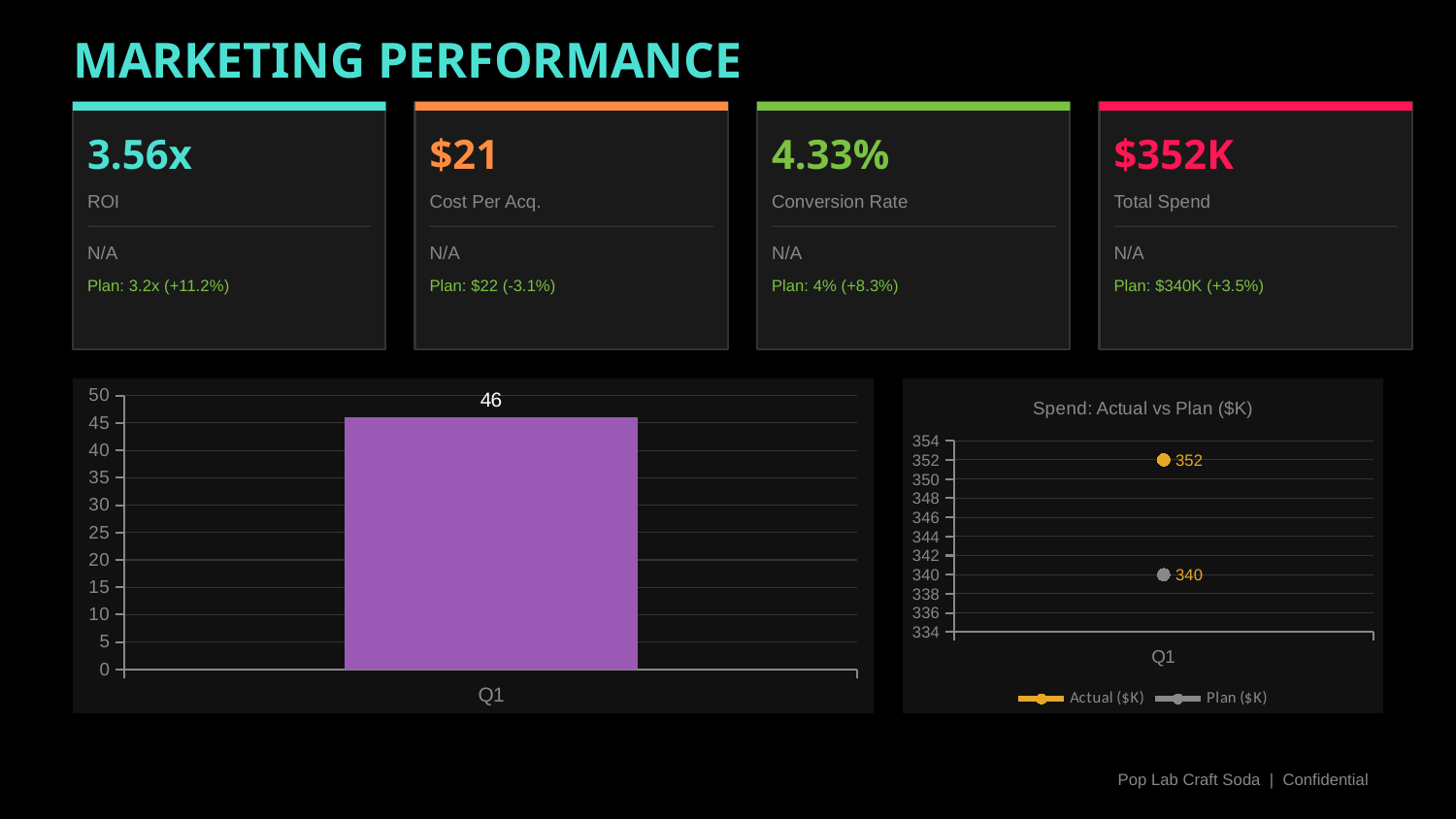
In the chart titled 'Spend: Actual vs Plan ($K)', what is the difference between the Actual ($K) and Plan ($K) values for Q1? 12 In the chart titled 'Spend: Actual vs Plan ($K)', what is the Plan ($K) value for Q1? 340 What kind of chart is the chart on the left of the slide? bar chart How many categories are shown on the x axis of the bar chart on the left? 1 In the bar chart on the left, what is the value for Q1? 46 What is the title of the chart on the right of the slide? Spend: Actual vs Plan ($K) In the chart titled 'Spend: Actual vs Plan ($K)', which is larger for Q1, Actual ($K) or Plan ($K)? Actual ($K) In the chart titled 'Spend: Actual vs Plan ($K)', what is the Actual ($K) value for Q1? 352 In the bar chart on the left, is the value for Q1 greater or less than 50? less How many series does the legend of the chart titled 'Spend: Actual vs Plan ($K)' list? 2 In the chart titled 'Spend: Actual vs Plan ($K)', what colour is the Actual ($K) marker? orange In the bar chart on the left, is the value for Q1 greater or less than 40? greater